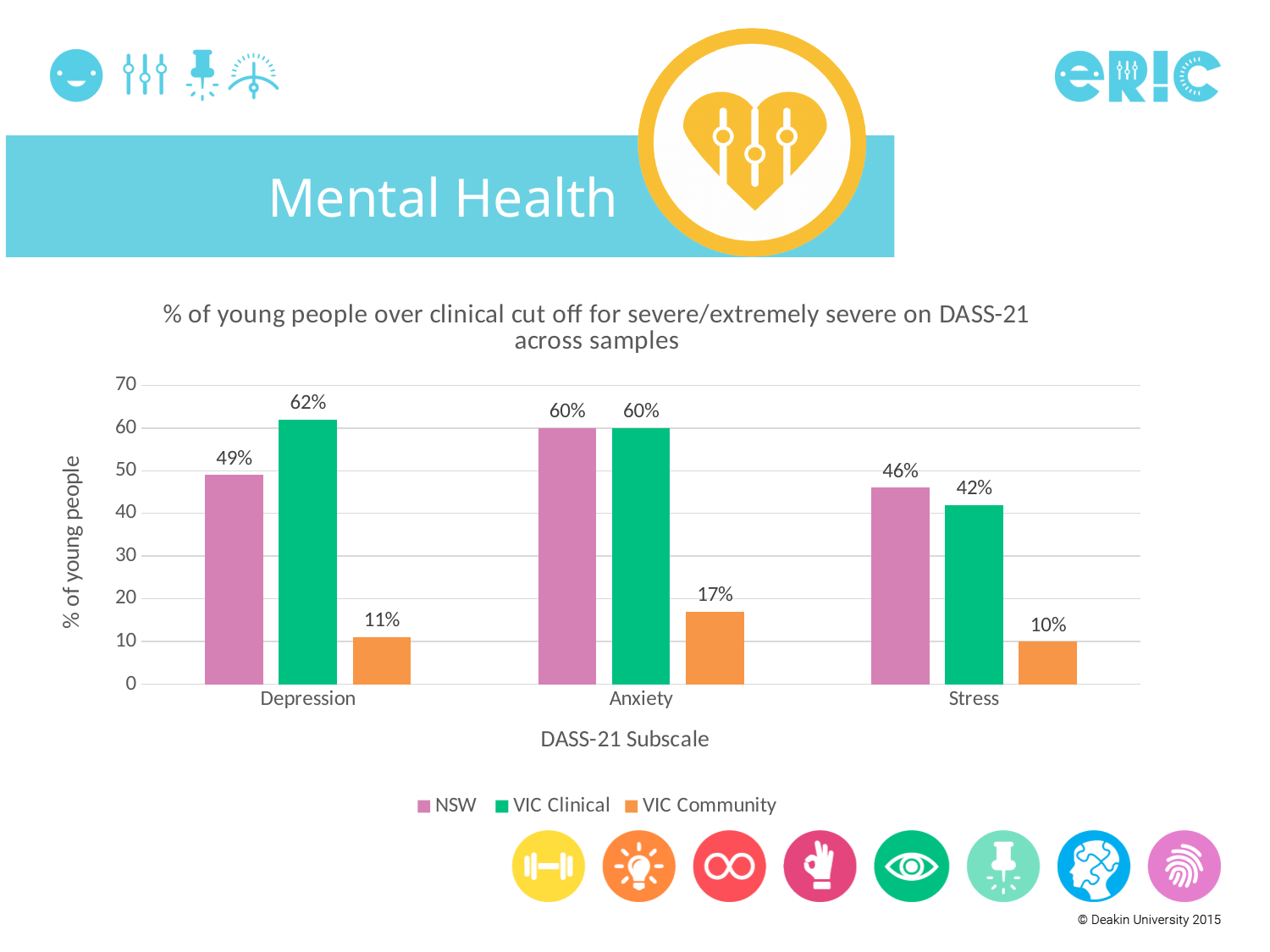
How many series does the legend list? 3 What is the value for NSW on the Stress subscale? 46% What kind of chart is shown on the slide? Bar chart Which subscale has the lowest value for the NSW series? Stress What is the value for VIC Clinical on the Depression subscale? 62% How many DASS-21 subscales are shown on the x axis? 3 Which is larger on the Stress subscale: NSW or VIC Clinical? NSW What is the label of the y axis? % of young people What is the value for VIC Community on the Anxiety subscale? 17% Is the value for VIC Community on the Stress subscale greater or less than 20? less What is the difference between the VIC Clinical and VIC Community values on the Depression subscale? 51% Which subscale has the highest value for the VIC Community series? Anxiety